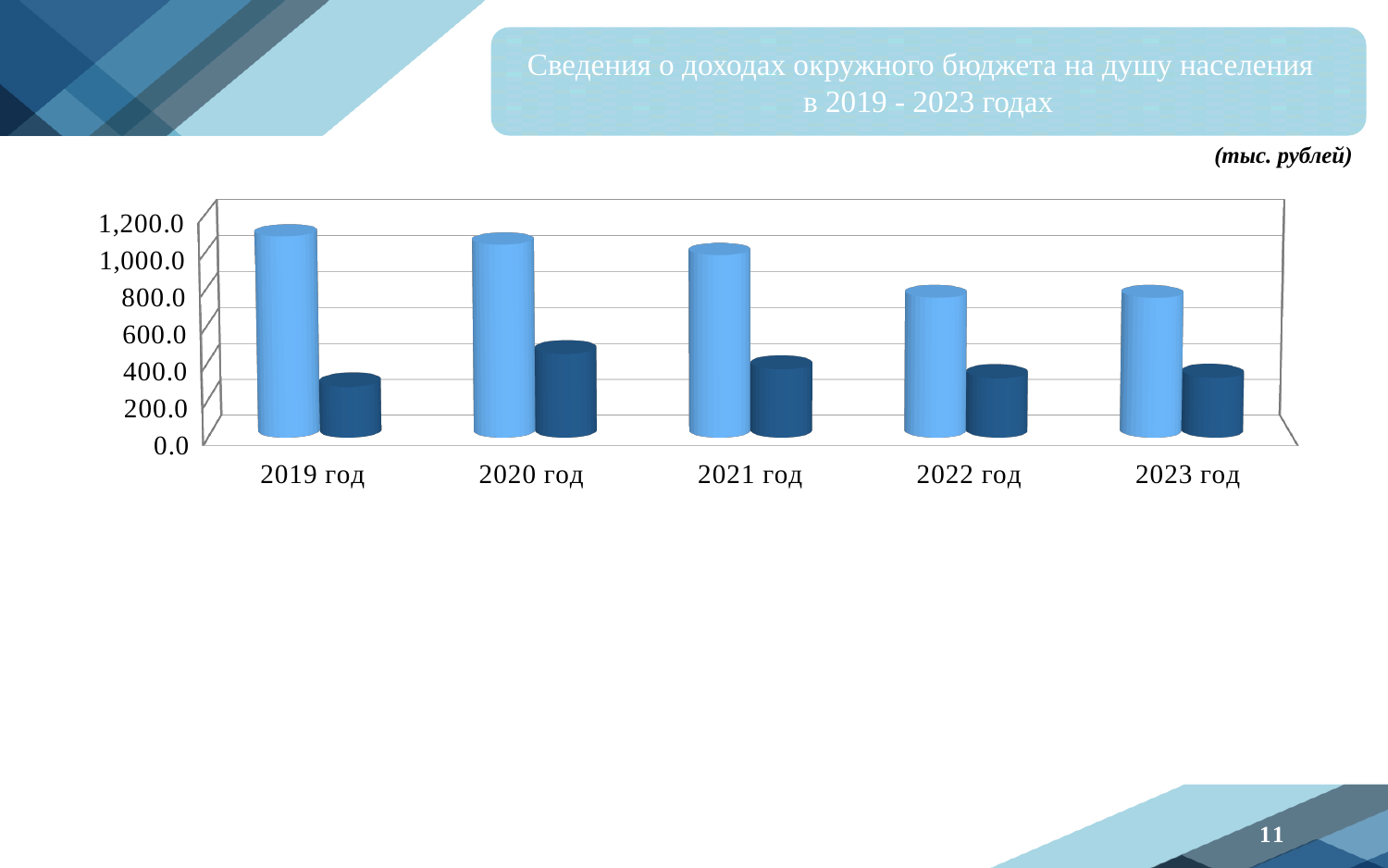
In which year is the dark blue bar the tallest? 2020 год How many year categories are shown on the x axis of the chart? 5 Is the light blue bar for 2019 год greater or less than 1,000.0? greater Is the dark blue bar for 2019 год greater or less than 600.0? less What kind of chart is shown on the slide? bar chart In which year is the light blue bar the tallest? 2019 год Which is larger: the dark blue bar for 2020 год or the dark blue bar for 2022 год? 2020 год Do the light blue bars generally rise or fall from 2019 год to 2023 год? fall Is the dark blue bar for 2020 год greater or less than 600.0? less Which is larger: the light blue bar for 2019 год or the light blue bar for 2021 год? 2019 год What unit is stated above the chart for the values? тыс. рублей